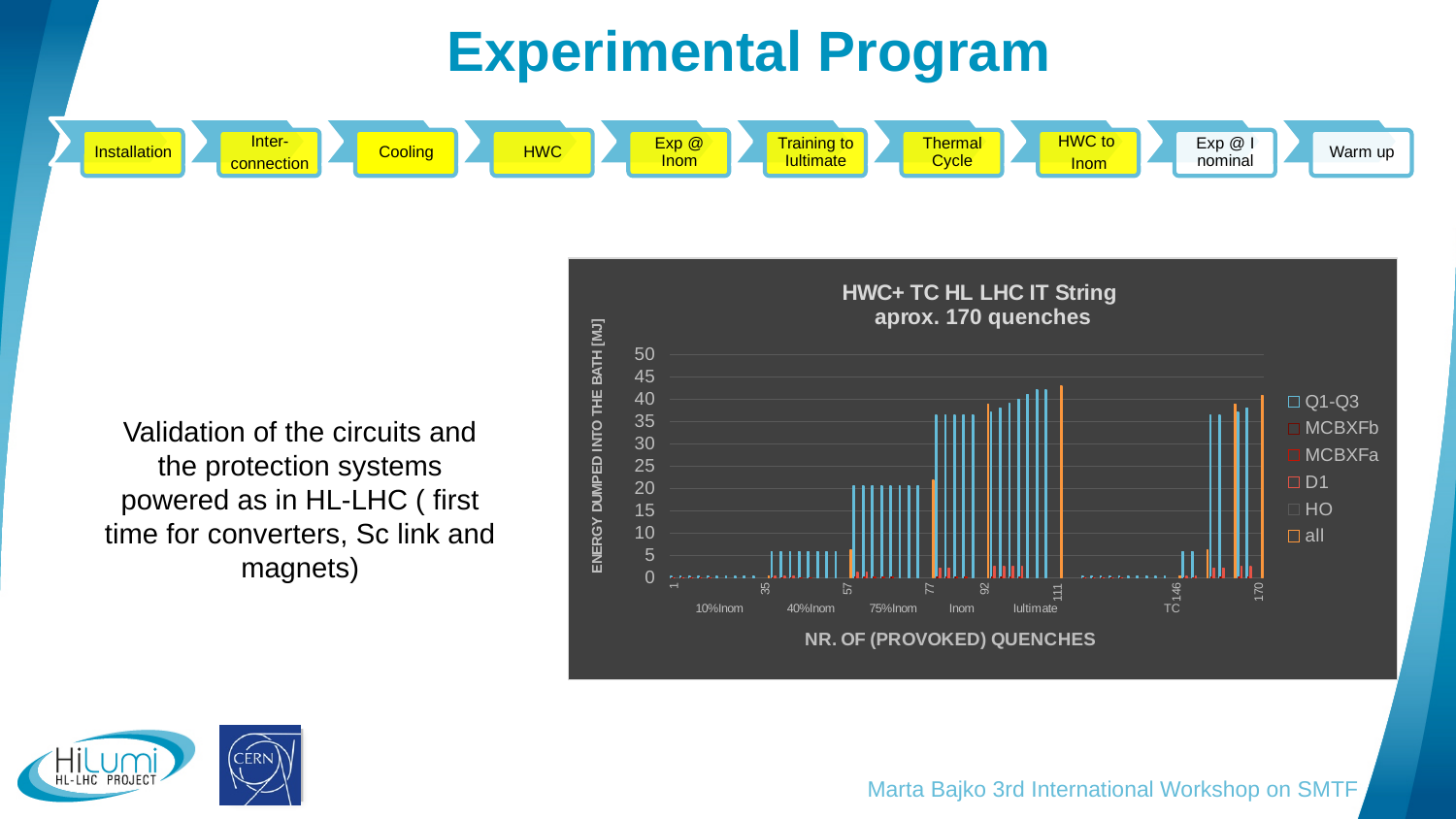
Is the energy dumped for the Q1-Q3 quenches in the Inom region greater or less than 30 MJ? greater Does the energy dumped into the bath generally rise or fall from the 10%Inom region to the Iultimate region? rise Which region has taller Q1-Q3 bars, 75%Inom or Inom? Inom Is the tallest bar in the chart greater or less than 40 MJ? greater Is the energy dumped for the Q1-Q3 quenches in the 75%Inom region greater or less than 10 MJ? greater What is the title of the chart? HWC+ TC HL LHC IT String aprox. 170 quenches How many series does the chart legend list? 6 What type of chart is shown on the slide? bar chart What is the label of the vertical axis of the chart? ENERGY DUMPED INTO THE BATH [MJ] How many current-level regions (10%Inom, 40%Inom, etc.) are labelled along the x axis? 6